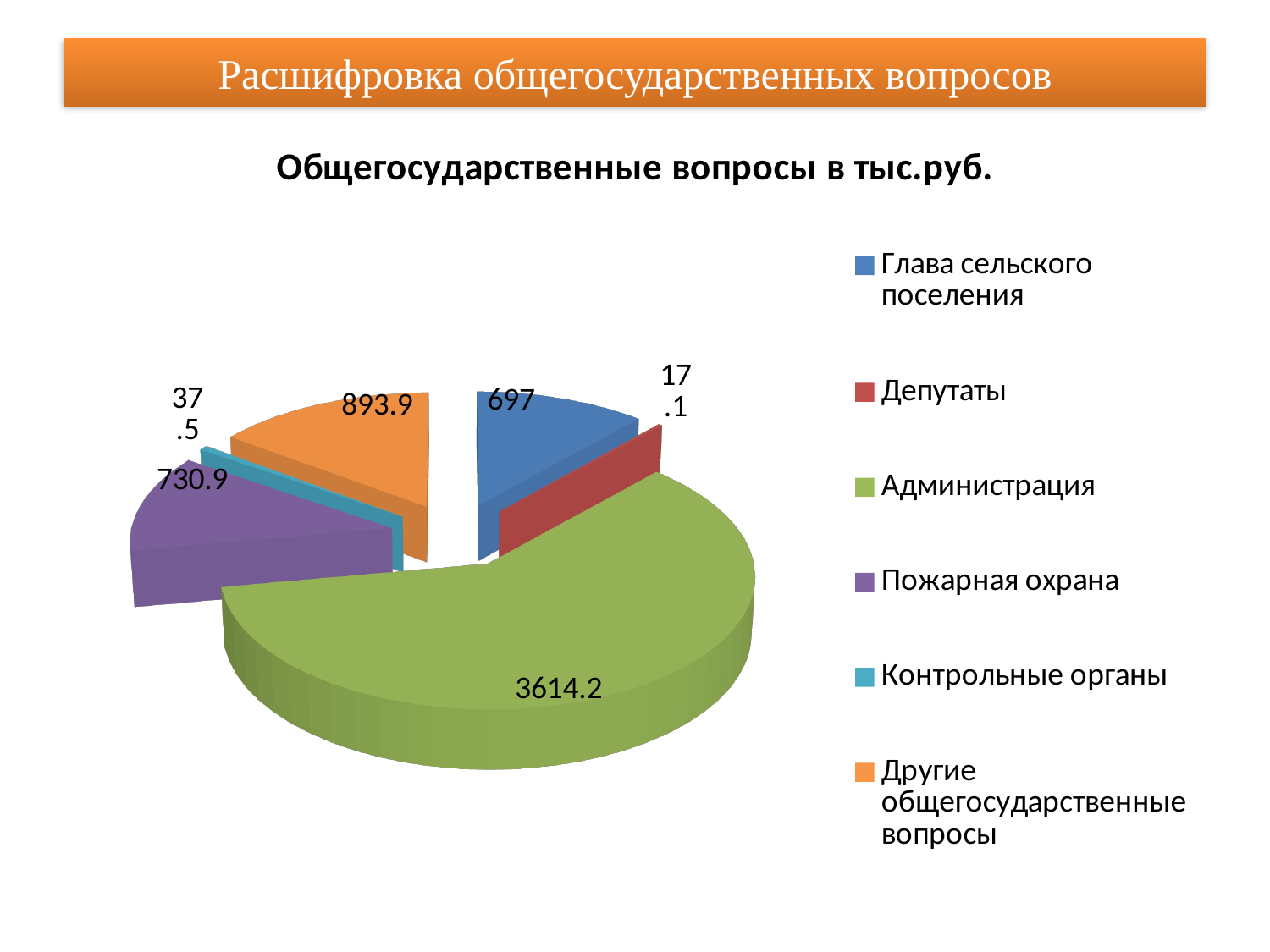
What type of chart is shown on the slide? pie chart How many categories does the legend list? 6 Which category has the smallest slice of the pie? Депутаты What is the value for Пожарная охрана? 730.9 What is the difference between Другие общегосударственные вопросы and Пожарная охрана? 163 What is the value for Другие общегосударственные вопросы? 893.9 Which is larger, Пожарная охрана or Другие общегосударственные вопросы? Другие общегосударственные вопросы What is the value for Контрольные органы? 37.5 What is the value for Глава сельского поселения? 697 Which category has the largest slice of the pie? Администрация What is the value for Администрация? 3614.2 What is the value for Депутаты? 17.1